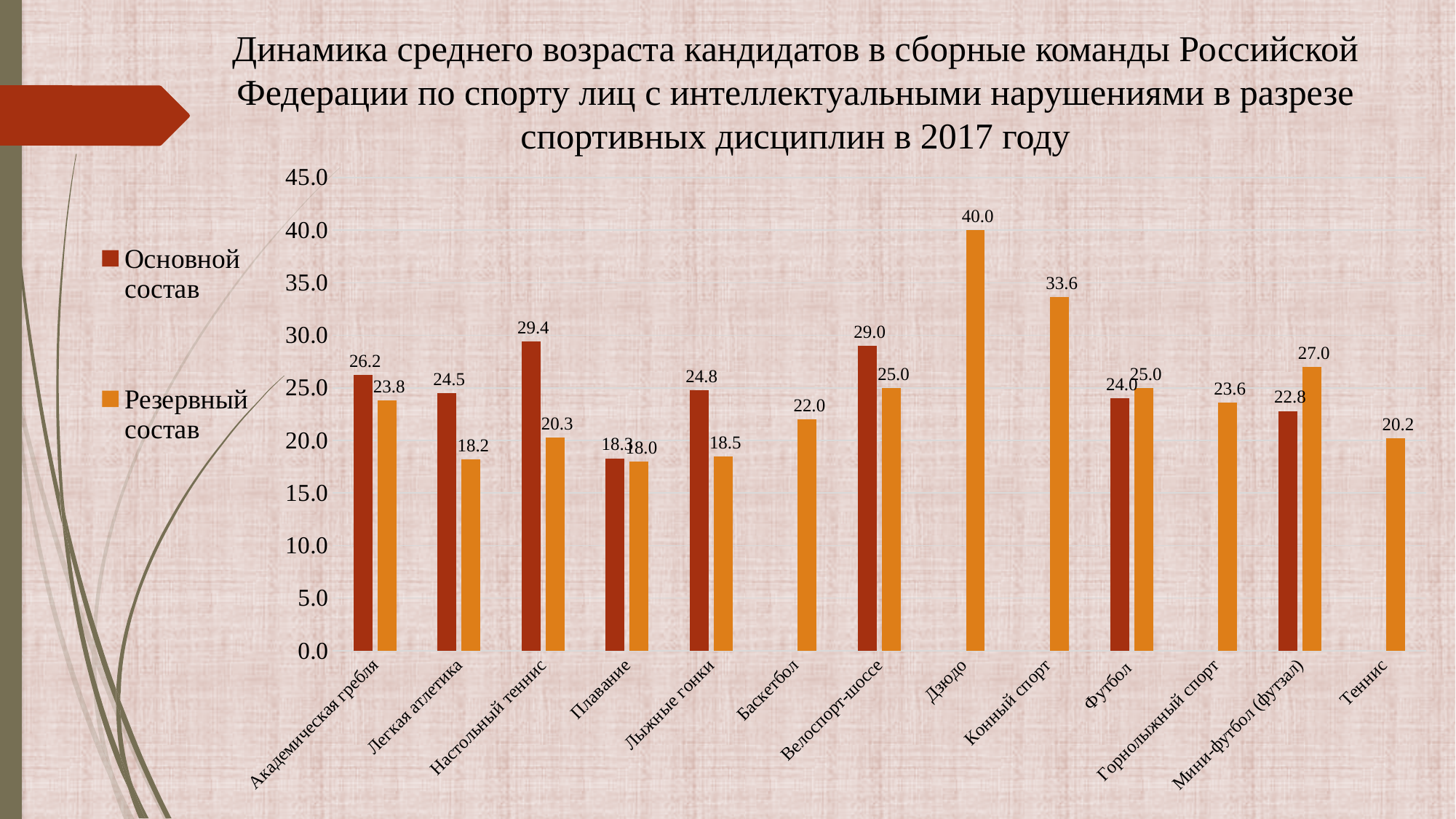
What is the difference between Основной состав and Резервный состав in Легкая атлетика? 6.3 What is the value for Резервный состав in Теннис? 20.2 What is the value for Резервный состав in Конный спорт? 33.6 Which is larger in Мини-футбол (футзал): Основной состав or Резервный состав? Резервный состав What is the value for Основной состав in Велоспорт-шоссе? 29.0 What is the value for Основной состав in Настольный теннис? 29.4 Which category has the lowest value for Основной состав? Плавание What is the value for Резервный состав in Дзюдо? 40.0 How many series does the legend list? 2 Which category has the highest value for Резервный состав? Дзюдо What kind of chart is shown on the slide? Bar chart How many categories are shown on the x axis? 13